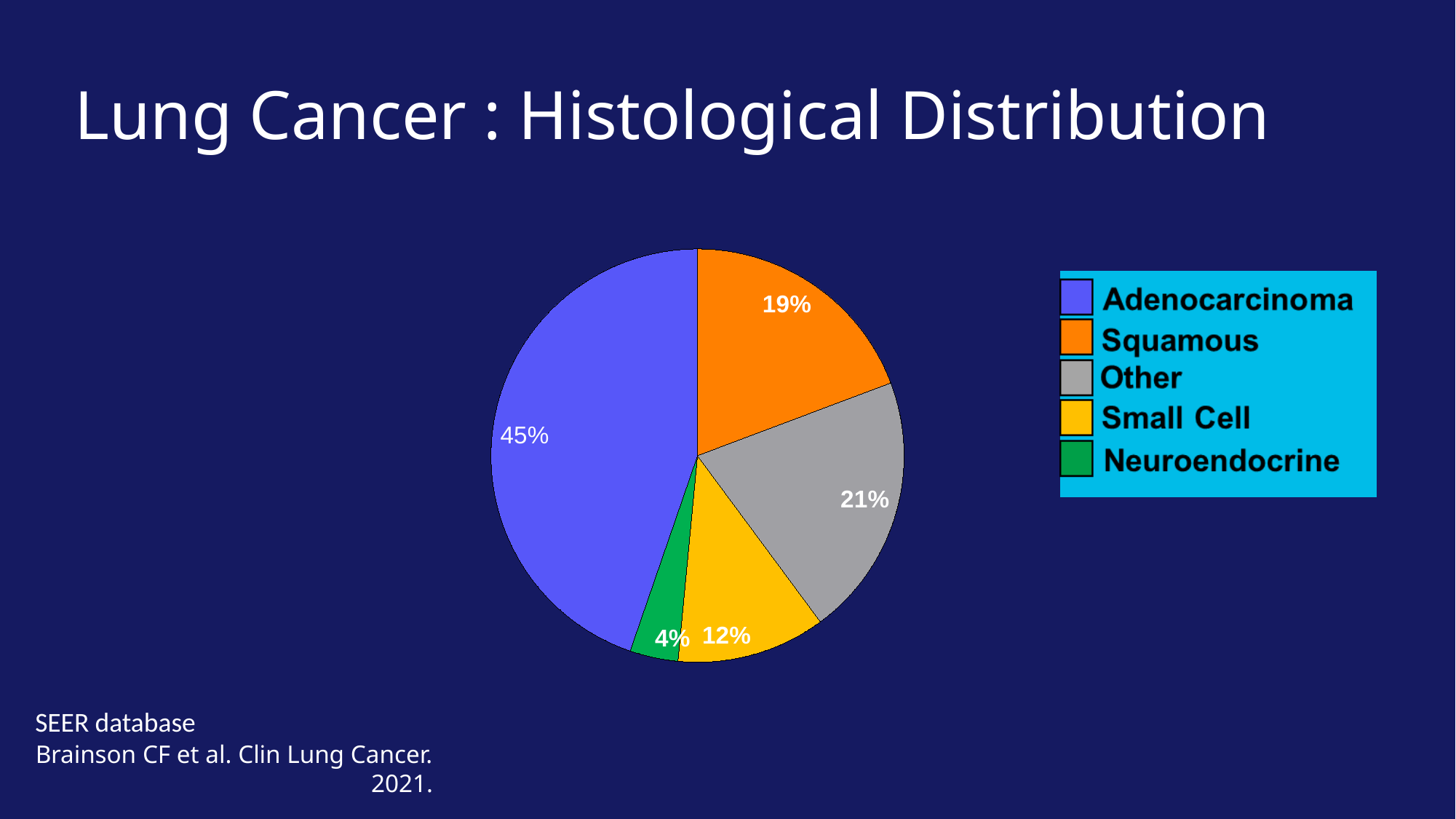
How many categories does the legend list? 5 What percentage is shown for the Other slice? 21% What percentage is shown for Neuroendocrine? 4% What percentage is shown for Squamous? 19% Which histological type has the largest slice of the pie? Adenocarcinoma What percentage is shown for Small Cell? 12% What kind of chart is shown on the slide? pie chart Which is larger, the Squamous slice or the Small Cell slice? Squamous Which histological type has the smallest slice of the pie? Neuroendocrine What is the difference in percentage points between Adenocarcinoma and Other? 24 What share of the pie does Adenocarcinoma account for? 45% What colour is the Small Cell slice in the pie chart? yellow